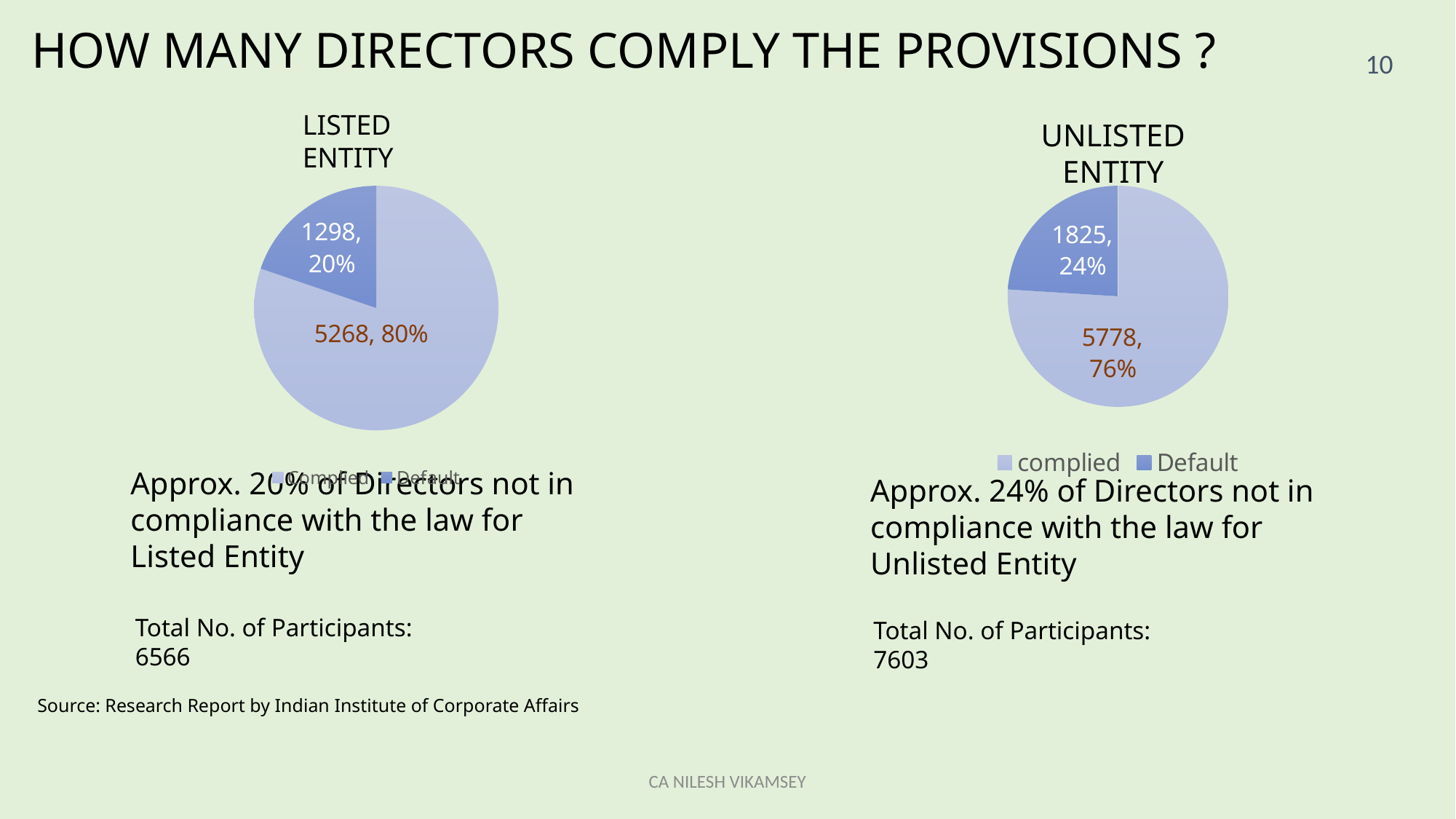
In the LISTED ENTITY chart, what is the value for Default? 1298 How many slices does the UNLISTED ENTITY pie chart have? 2 In the LISTED ENTITY chart, what share of the pie is the Default slice? 20% Which is larger: the Default value in the LISTED ENTITY chart or the Default value in the UNLISTED ENTITY chart? UNLISTED ENTITY What type of chart is the LISTED ENTITY chart? pie chart In the UNLISTED ENTITY chart, what is the value for complied? 5778 In the UNLISTED ENTITY chart, what is the value for Default? 1825 In the UNLISTED ENTITY chart, what is the difference between the complied and Default values? 3953 In the LISTED ENTITY chart, what is the value for Complied? 5268 In the LISTED ENTITY chart, which slice is the smallest? Default In the UNLISTED ENTITY chart, which slice is the largest? complied In the UNLISTED ENTITY chart, what share of the pie is the complied slice? 76%